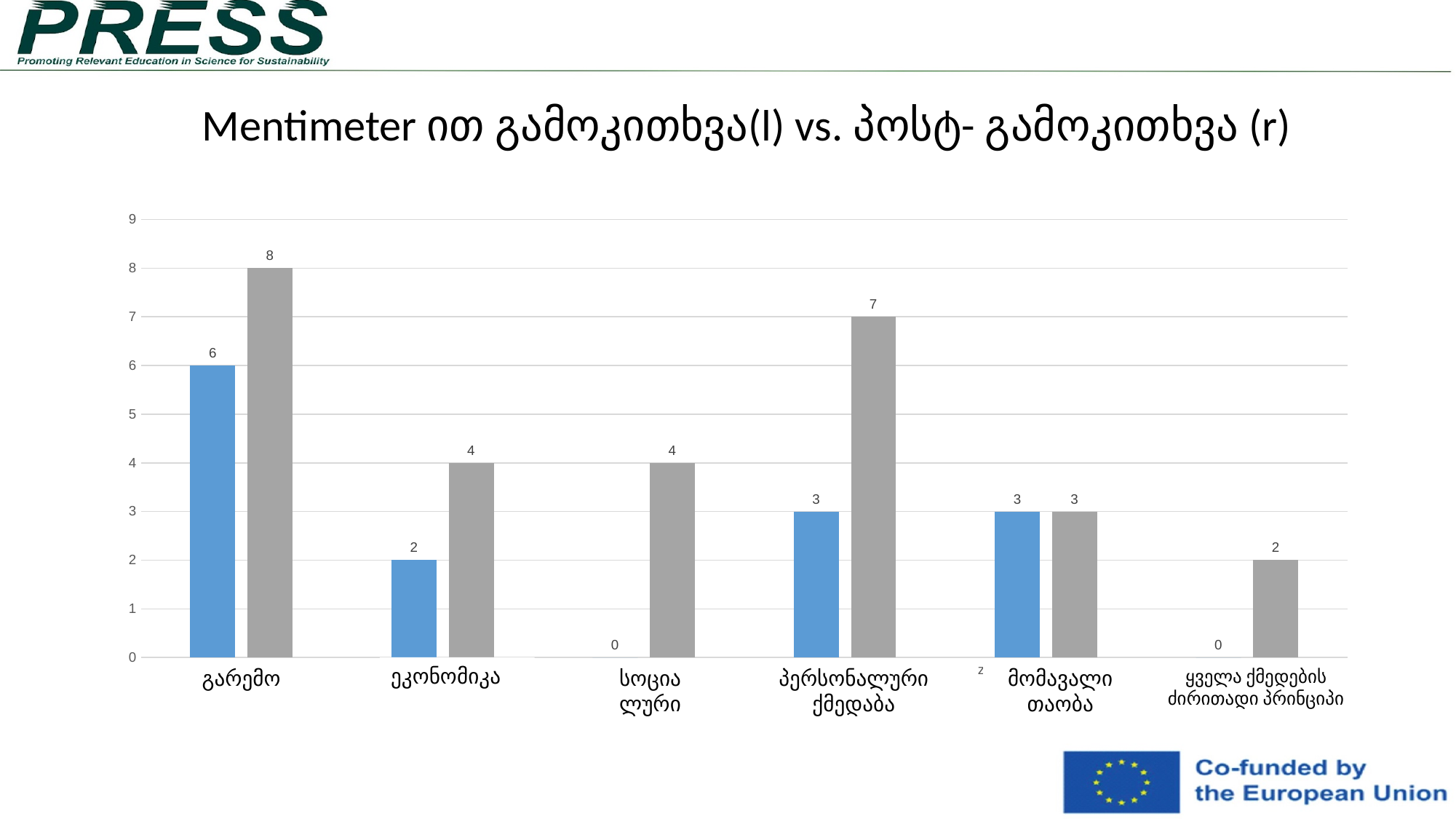
Which is larger for ეკონომიკა: the blue (left) bar or the gray (right) bar? the gray (right) bar Which category has the lowest gray (right) bar? ყველა ქმედების ძირითადი პრინციპი What is the value of the gray (right) bar for გარემო? 8 What is the value of the blue (left) bar for სოციალური? 0 How many categories are shown on the x axis of the chart? 6 What is the title of the chart on the slide? Mentimeter ით გამოკითხვა(I) vs. პოსტ- გამოკითხვა (r) What is the value of the gray (right) bar for ყველა ქმედების ძირითადი პრინციპი? 2 What is the difference between the gray (right) bar and the blue (left) bar for პერსონალური ქმედება? 4 What is the value of the blue (left) bar for გარემო? 6 What is the value of the gray (right) bar for პერსონალური ქმედება? 7 What type of chart is shown on the slide? bar chart Which category has the highest gray (right) bar? გარემო